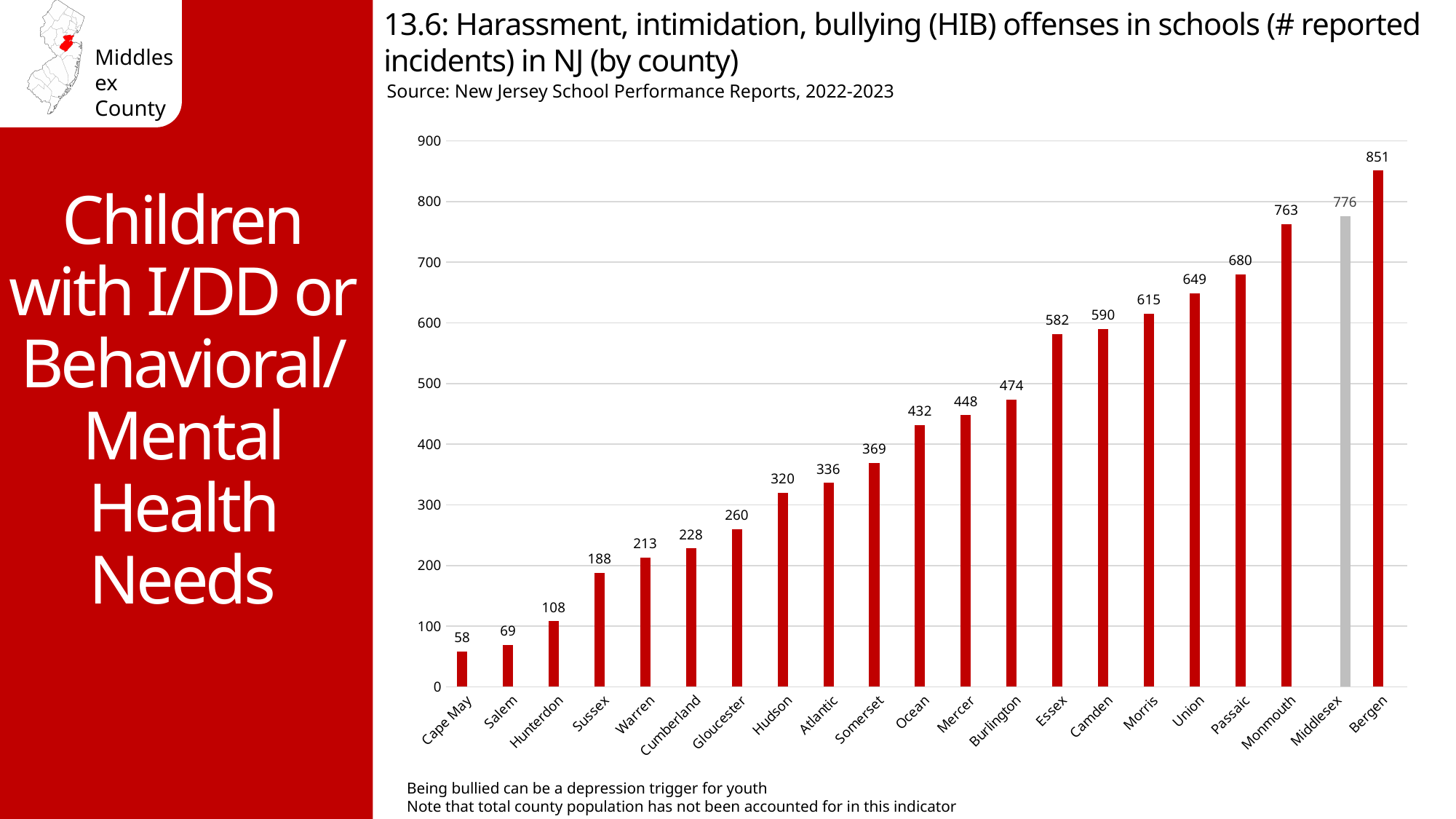
What is the difference between the values for Salem and Cape May? 11 Which bar is shown in a different colour (grey) from the others? Middlesex Which has more reported HIB incidents, Essex or Camden? Camden What kind of chart is shown on the slide? Bar chart Which county has the highest number of reported HIB incidents? Bergen Is the value for Monmouth greater or less than 700? greater Do the values rise or fall from left to right along the x axis? Rise How many counties are shown on the chart? 21 What is the number of reported HIB incidents for Hudson? 320 What is the number of reported HIB incidents for Middlesex? 776 Which county has the lowest number of reported HIB incidents? Cape May What is the difference between the values for Bergen and Middlesex? 75